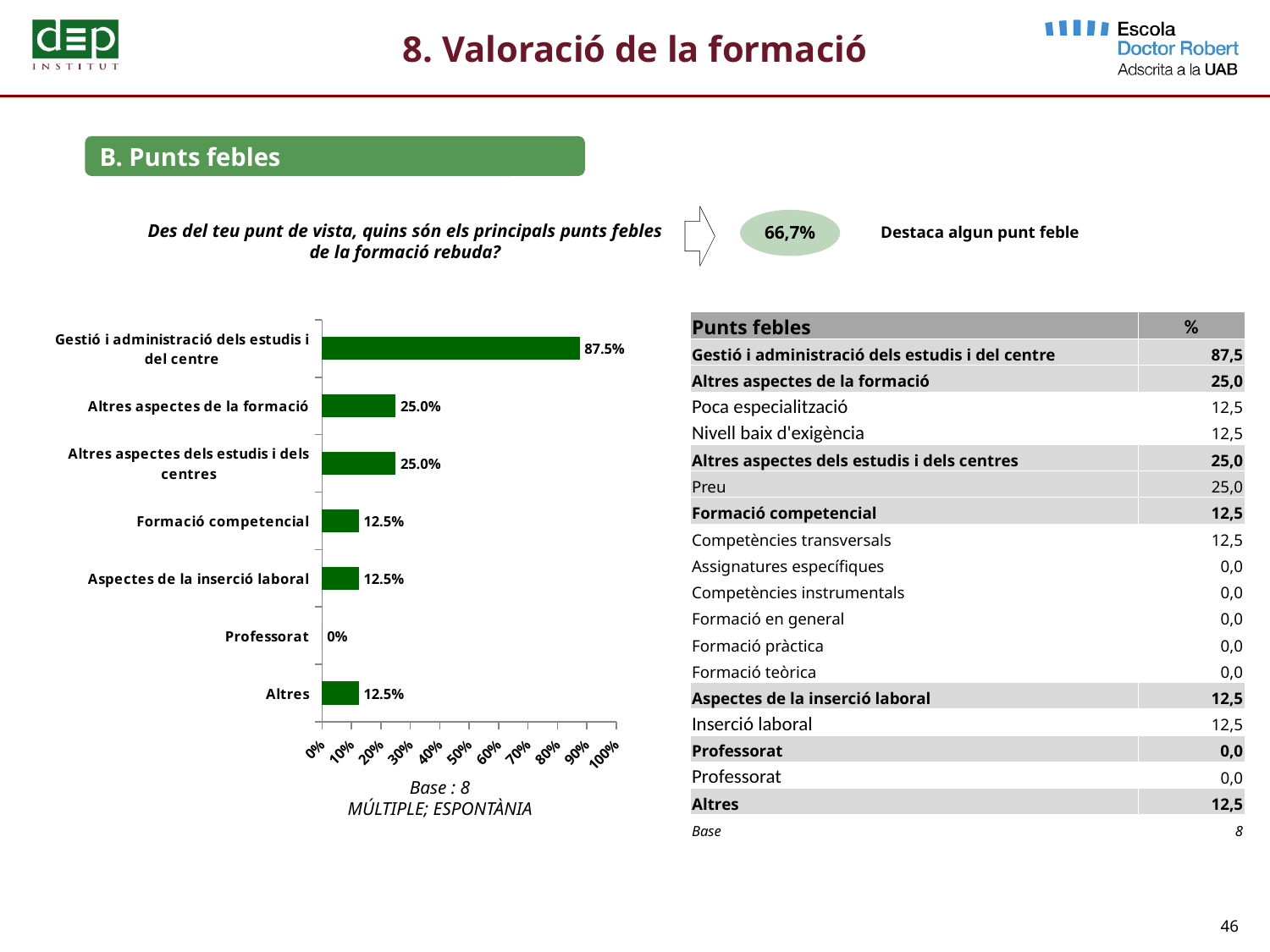
Which category has the lowest value? Professorat What is the difference between the values for Gestió i administració dels estudis i del centre and Altres aspectes de la formació? 62.5% What is the value for Professorat? 0% What is the value for Altres? 12.5% What kind of chart is shown on the slide? bar chart What is the value for Gestió i administració dels estudis i del centre? 87.5% Is the value for Gestió i administració dels estudis i del centre greater or less than 80%? greater Which category has the highest value? Gestió i administració dels estudis i del centre What is the base (number of respondents) stated below the chart? 8 Which is larger, the value for Altres aspectes dels estudis i dels centres or the value for Formació competencial? Altres aspectes dels estudis i dels centres How many categories are shown in the chart? 7 What is the value for Altres aspectes de la formació? 25.0%